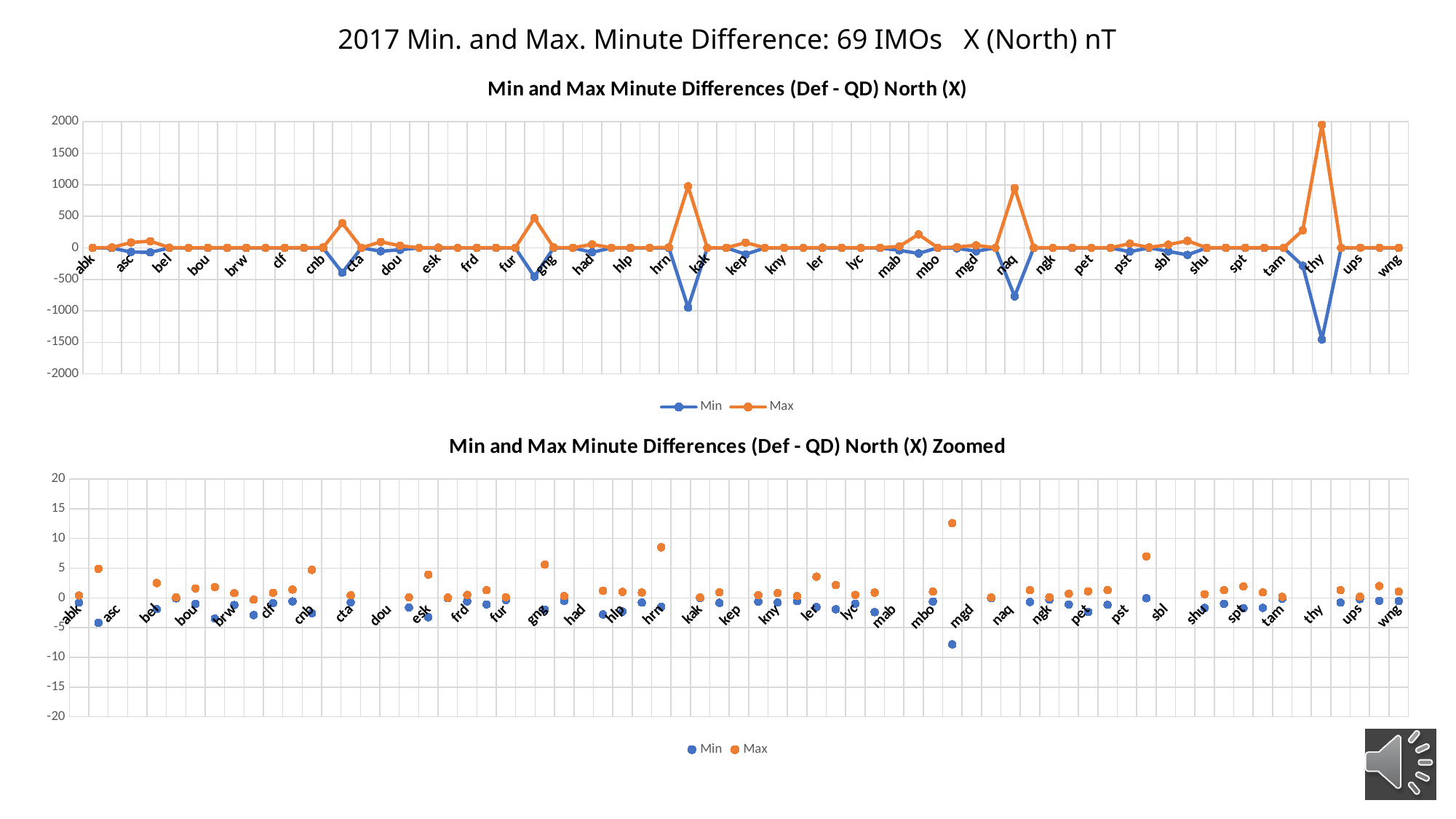
How many series does the legend of the top chart list? 2 In the top chart, is the Max value for thy greater or less than 1500? greater In the top chart, which is larger: the Max value for thy or the Max value for kak? thy In the top chart, which category has the lowest Min value? thy In the top chart, is the Min value for kak greater or less than -500? greater In the top chart, which colour is used for the Max series? orange In the top chart, is the Max value for naq greater or less than 500? greater What kind of chart is the top chart? line chart In the top chart, which category has the highest Max value? thy